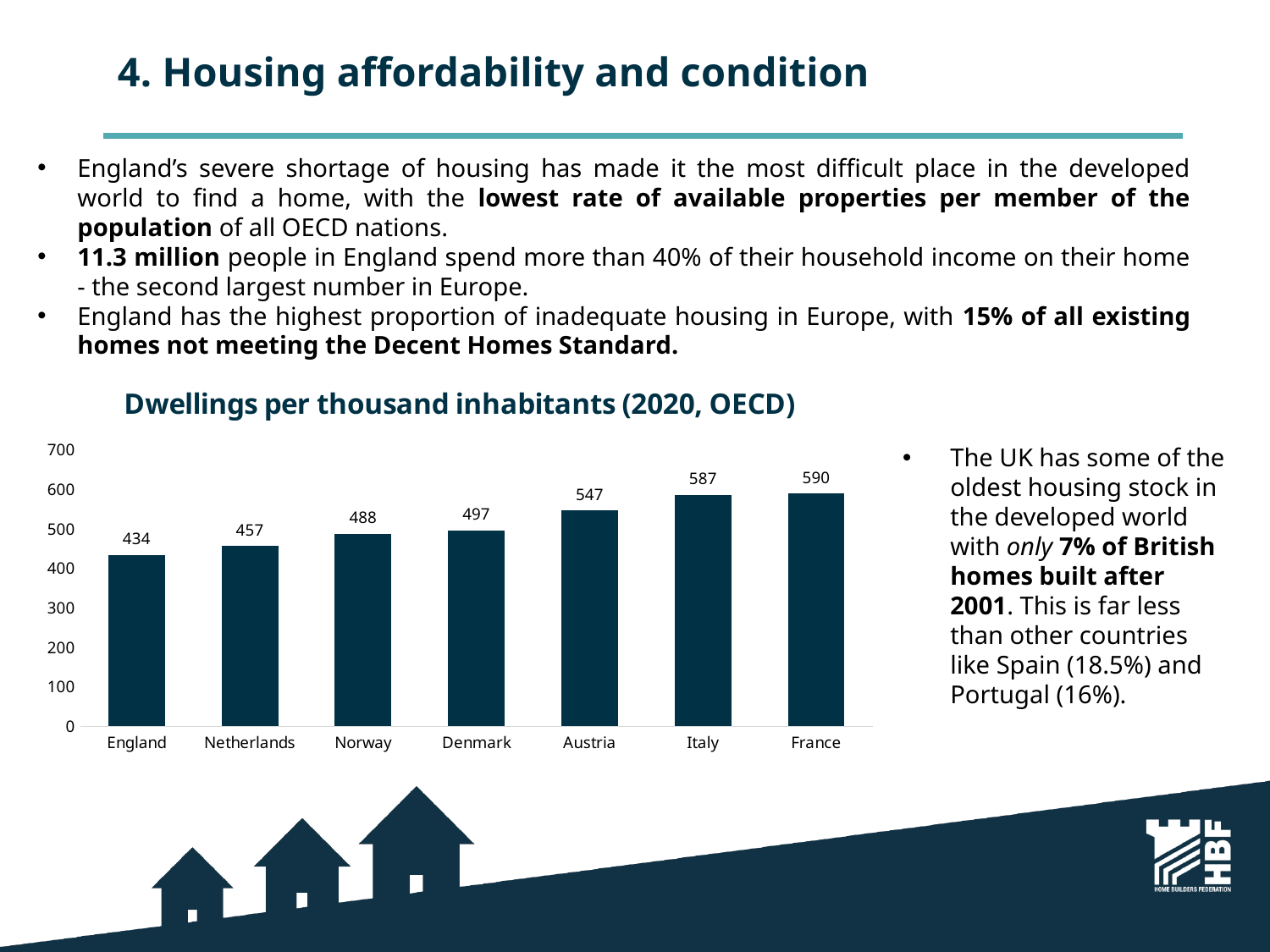
What is the difference between the values for Austria and Norway? 59 Which has a higher value, Netherlands or Denmark? Denmark What is the title of the chart? Dwellings per thousand inhabitants (2020, OECD) Which country has the lowest number of dwellings per thousand inhabitants? England Which country has the highest number of dwellings per thousand inhabitants? France What is the value for Denmark in the chart? 497 Is the value for Norway greater or less than 500? less What is the value for England in the chart? 434 What kind of chart is shown on the slide? Bar chart How many countries are shown in the chart? 7 What is the difference between the values for France and England? 156 What is the value for Italy in the chart? 587